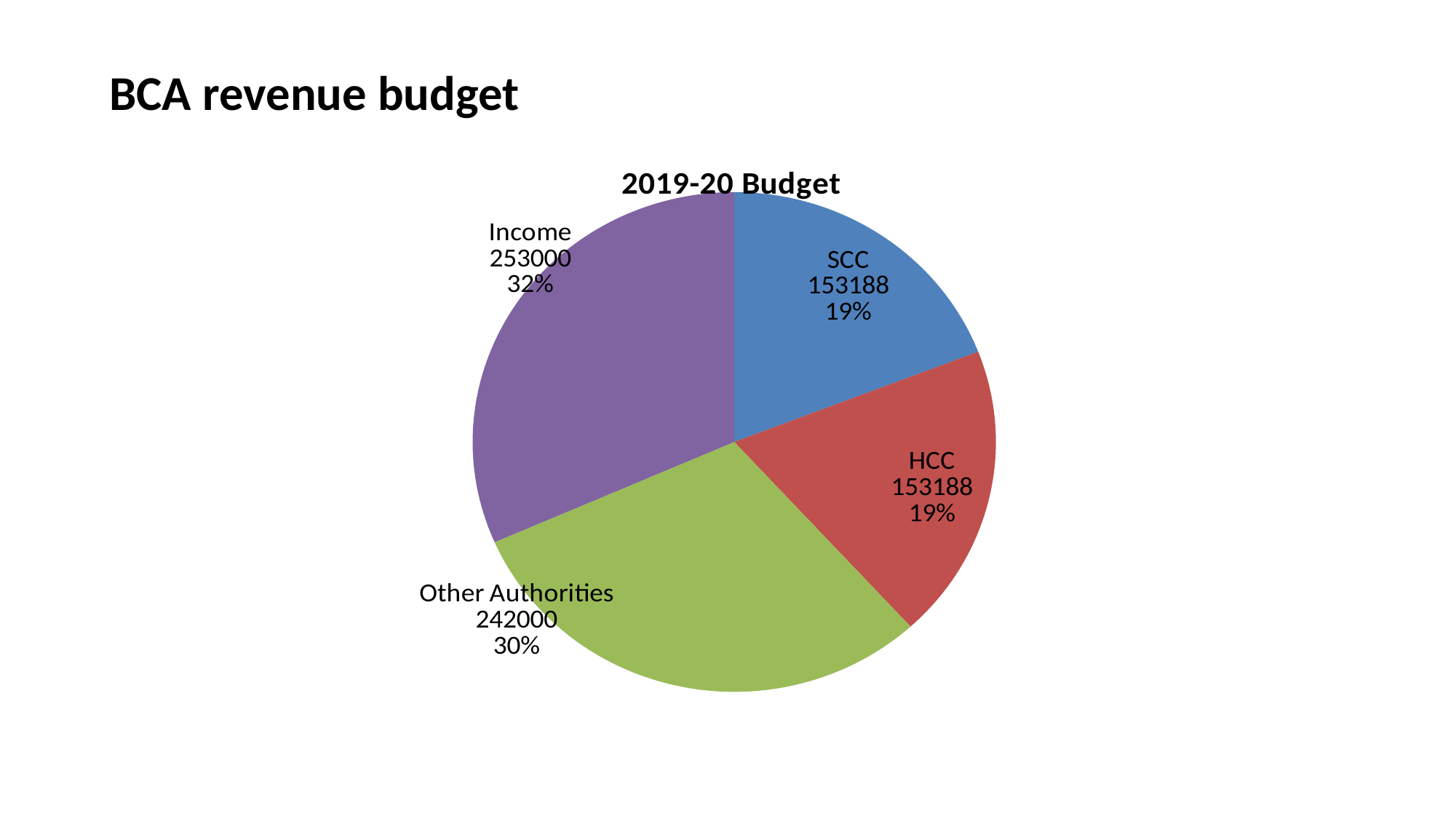
What is the value for Other Authorities? 242000 How many slices does the pie chart have? 4 What share of the pie does HCC represent? 19% What share of the pie does Income represent? 32% Which category has the largest slice? Income What is the difference between the values for Other Authorities and HCC? 88812 Which is larger, the value for Income or the value for Other Authorities? Income What is the title of the chart? 2019-20 Budget What is the value for Income? 253000 What is the difference between the values for Income and Other Authorities? 11000 What kind of chart is shown on the slide? Pie chart What is the value for SCC? 153188